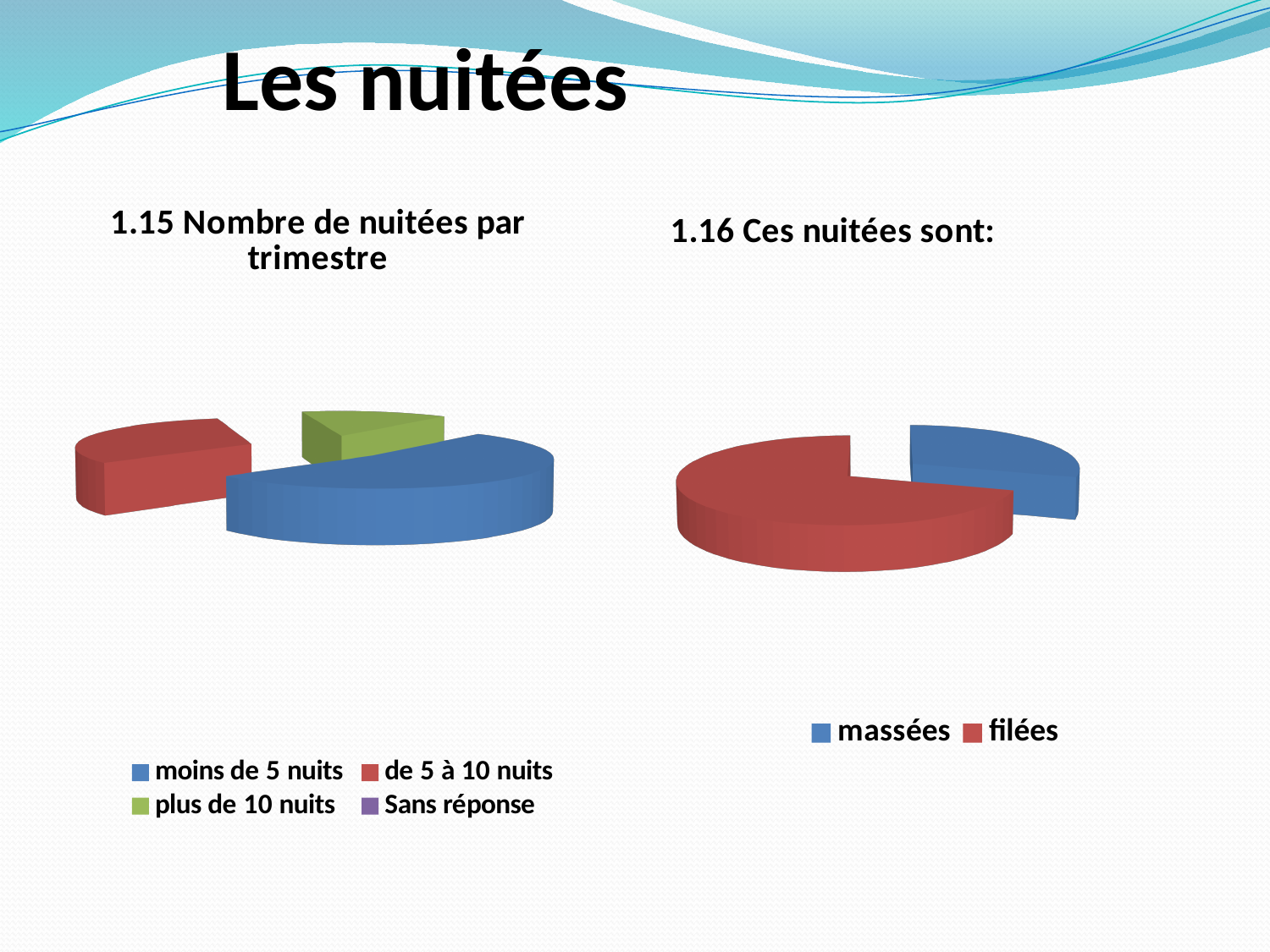
In the chart titled "1.15 Nombre de nuitées par trimestre", what colour represents "plus de 10 nuits"? green In the chart titled "1.15 Nombre de nuitées par trimestre", how many categories does the legend list? 4 What is the title of the chart on the right side of the slide? 1.16 Ces nuitées sont: In the chart titled "1.16 Ces nuitées sont:", which category has the largest slice? filées In the chart titled "1.15 Nombre de nuitées par trimestre", which slice is larger: "moins de 5 nuits" or "plus de 10 nuits"? moins de 5 nuits In the chart titled "1.16 Ces nuitées sont:", how many categories does the legend list? 2 In the chart titled "1.15 Nombre de nuitées par trimestre", which slice is larger: "de 5 à 10 nuits" or "plus de 10 nuits"? de 5 à 10 nuits In the chart titled "1.15 Nombre de nuitées par trimestre", which category has the largest slice? moins de 5 nuits In the chart titled "1.16 Ces nuitées sont:", which category has the smallest slice? massées In the chart titled "1.16 Ces nuitées sont:", which slice is larger: "massées" or "filées"? filées What kind of chart is the chart titled "1.15 Nombre de nuitées par trimestre"? pie chart What kind of chart is the chart titled "1.16 Ces nuitées sont:"? pie chart